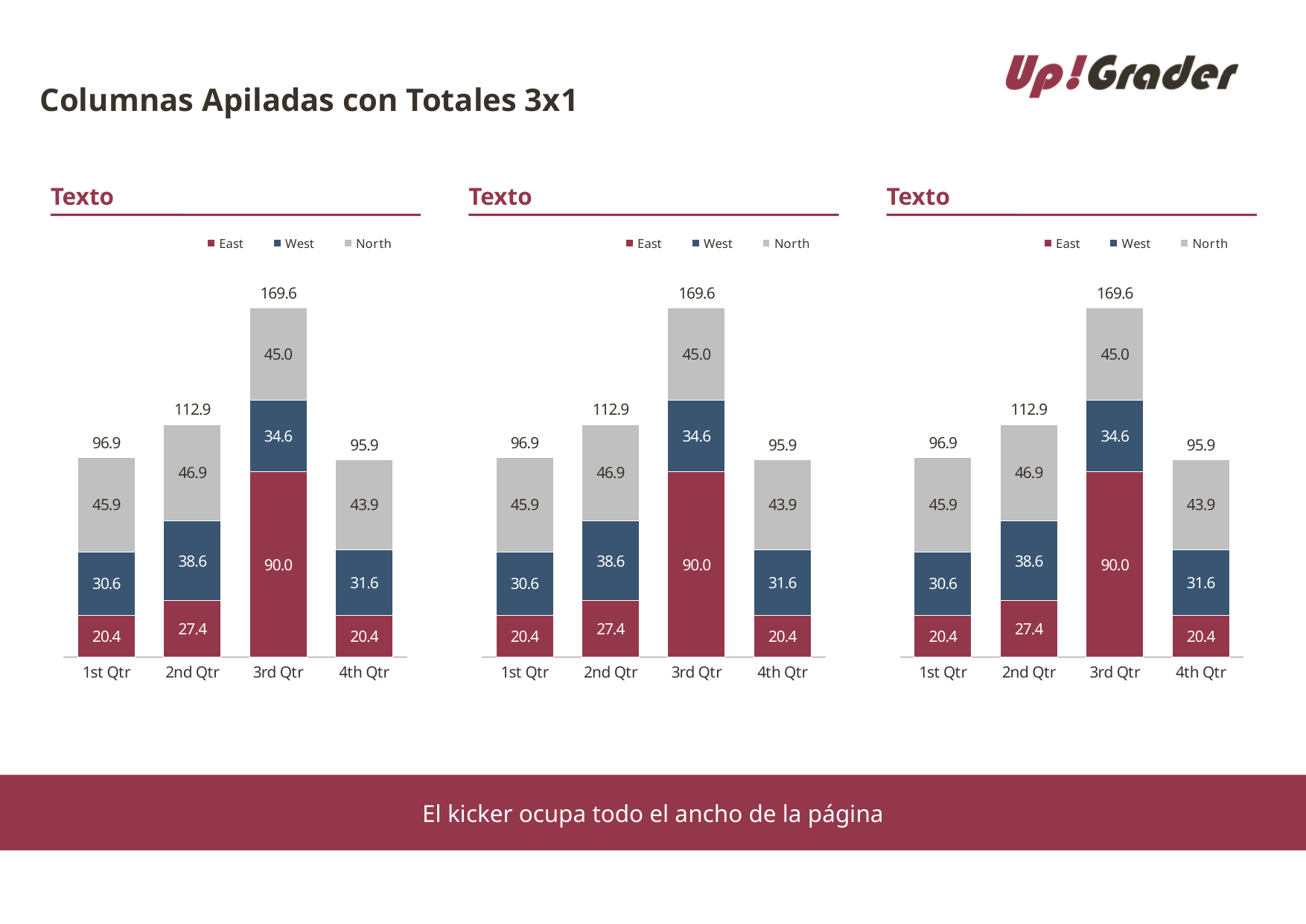
What kind of chart is the middle chart? Stacked bar chart Which series is shown in dark red in the right chart's legend? East In the left chart, what is the total of the stacked bar for 2nd Qtr? 112.9 In the left chart, what is the value for East in 3rd Qtr? 90.0 In the left chart, what is the difference between the East values for 3rd Qtr and 2nd Qtr? 62.6 How many quarters are shown on the x axis of the right chart? 4 In the middle chart, which is larger: the West value for 2nd Qtr or the West value for 3rd Qtr? 2nd Qtr In the right chart, which quarter has the lowest stacked total? 4th Qtr In the middle chart, what is the value for West in 2nd Qtr? 38.6 In the middle chart, which quarter has the highest stacked total? 3rd Qtr In the right chart, what is the value for North in 4th Qtr? 43.9 How many series does the legend of the left chart list? 3